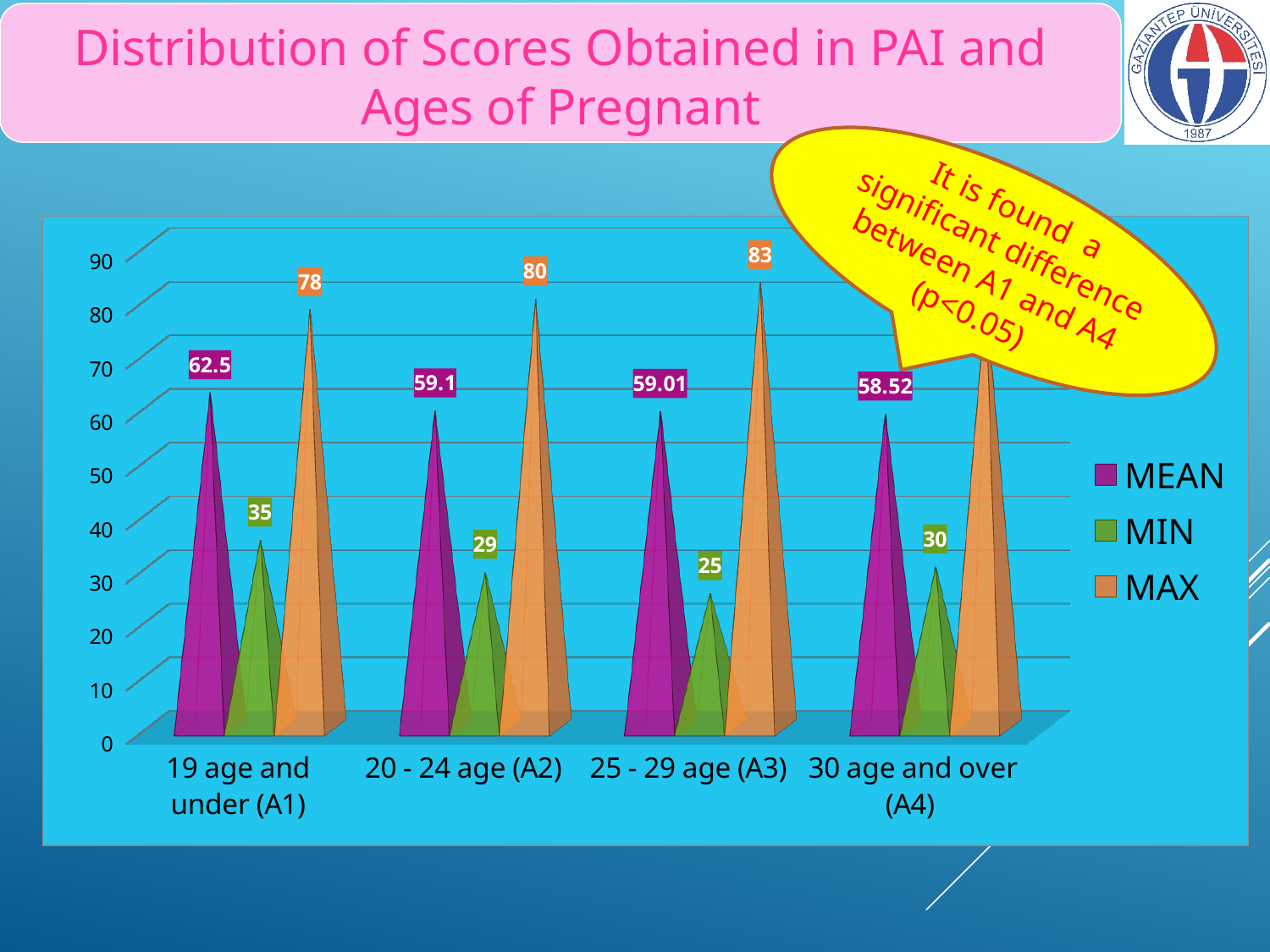
What is the MEAN score for the 30 age and over (A4) group? 58.52 How many series does the legend list? 3 What is the MAX score for the 20 - 24 age (A2) group? 80 Which age group has the lowest MIN score? 25 - 29 age (A3) Is the MAX value for the 30 age and over (A4) group greater or less than 60? greater What is the MIN score for the 25 - 29 age (A3) group? 25 How many age groups are shown on the x axis? 4 What is the difference between the MEAN scores of the A1 group and the A4 group? 3.98 Which is larger, the MIN score for the A1 group or the MIN score for the A4 group? A1 (35) Which age group has the highest MEAN score? 19 age and under (A1) What is the MEAN score for the 19 age and under (A1) group? 62.5 Which series is shown in green in the legend? MIN